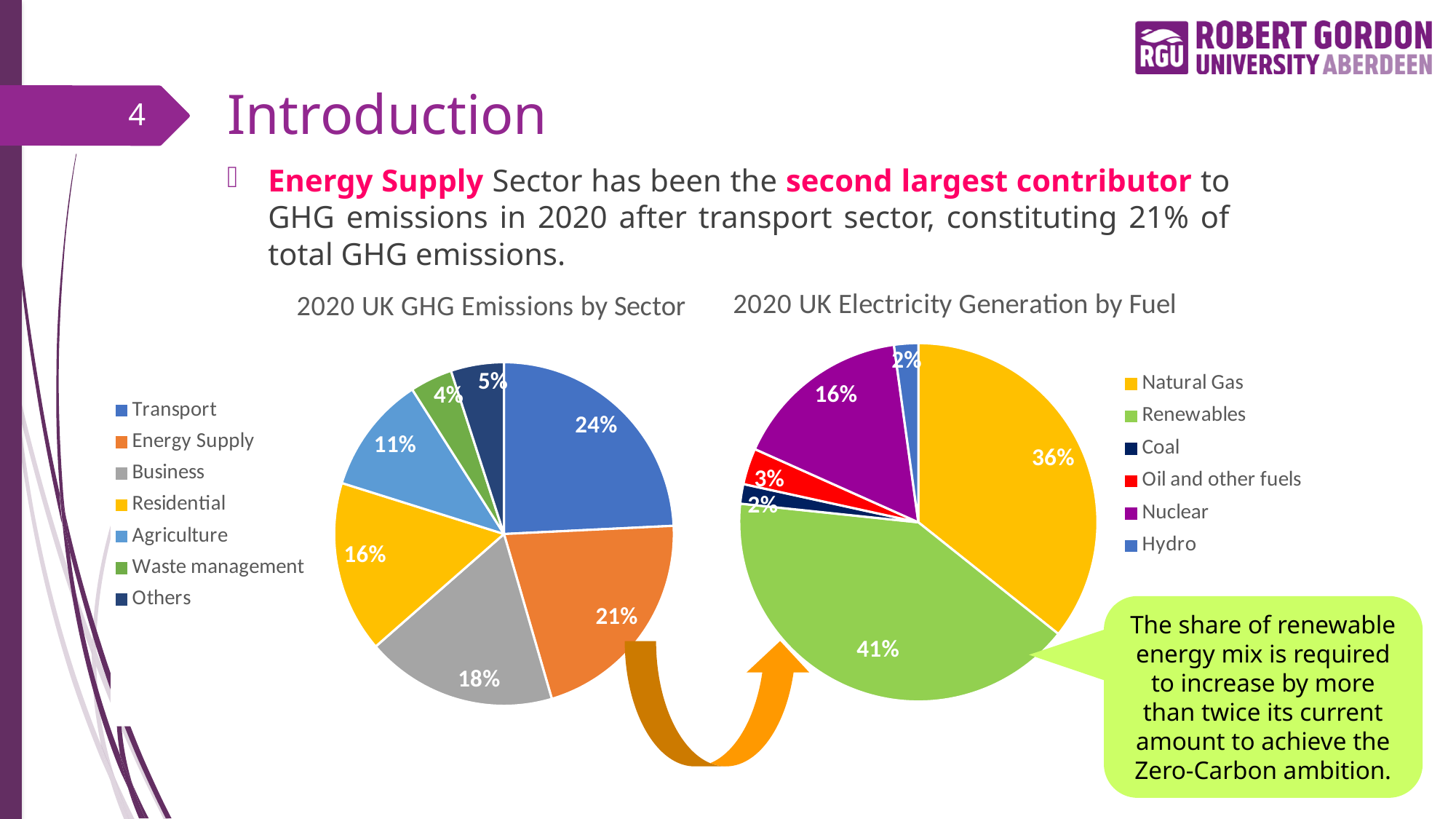
In the '2020 UK Electricity Generation by Fuel' chart, how many fuel categories does the legend list? 6 In the '2020 UK GHG Emissions by Sector' chart, which sector has the largest share? Transport In the '2020 UK GHG Emissions by Sector' chart, what share does Energy Supply have? 21% In the '2020 UK GHG Emissions by Sector' chart, which sector has the smallest share? Waste management In the '2020 UK GHG Emissions by Sector' chart, how many sectors are shown? 7 In the '2020 UK GHG Emissions by Sector' chart, what is the difference between the Transport and Business shares? 6% In the '2020 UK GHG Emissions by Sector' chart, which is larger, Residential or Agriculture? Residential In the '2020 UK Electricity Generation by Fuel' chart, what colour represents Nuclear? Purple In the '2020 UK Electricity Generation by Fuel' chart, what is the difference between the Renewables and Nuclear shares? 25% What type of chart is used for '2020 UK Electricity Generation by Fuel'? Pie chart In the '2020 UK Electricity Generation by Fuel' chart, which fuel has the largest share? Renewables In the '2020 UK Electricity Generation by Fuel' chart, what share does Natural Gas have? 36%